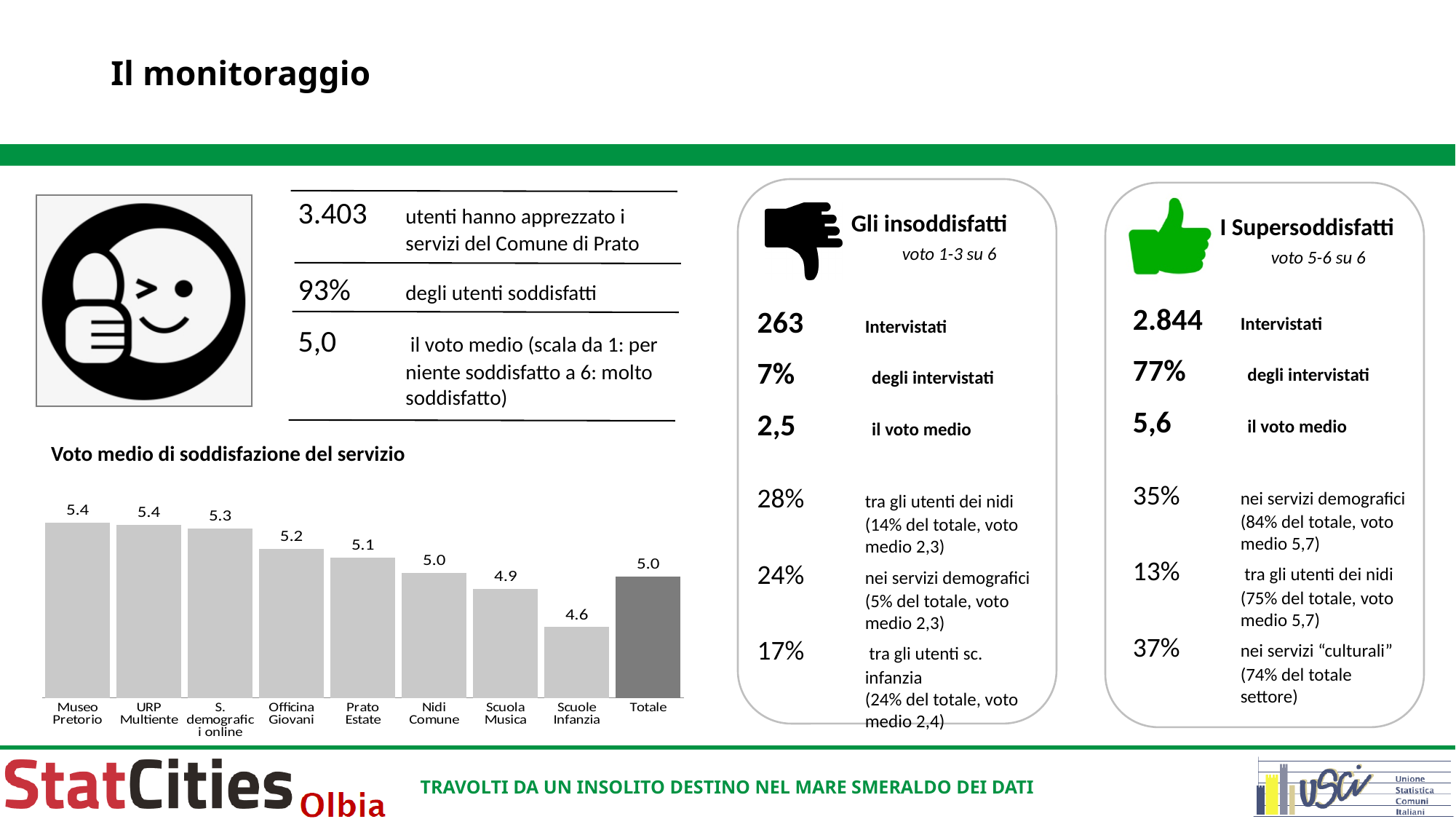
Which is larger, the value for Prato Estate or the value for Scuola Musica? Prato Estate What is the value for Museo Pretorio? 5.4 What is the title of the chart on the slide? Voto medio di soddisfazione del servizio What is the difference between the values for S. demografici online and Nidi Comune? 0.3 What is the value for Officina Giovani? 5.2 What is the value for Scuole Infanzia? 4.6 Do the values generally rise or fall from Museo Pretorio to Scuole Infanzia? fall What is the value for Totale? 5.0 What is the difference between the values for Museo Pretorio and Scuole Infanzia? 0.8 Which category has the lowest value in the chart? Scuole Infanzia How many bars are shown in the chart? 9 What type of chart is shown on the slide? bar chart